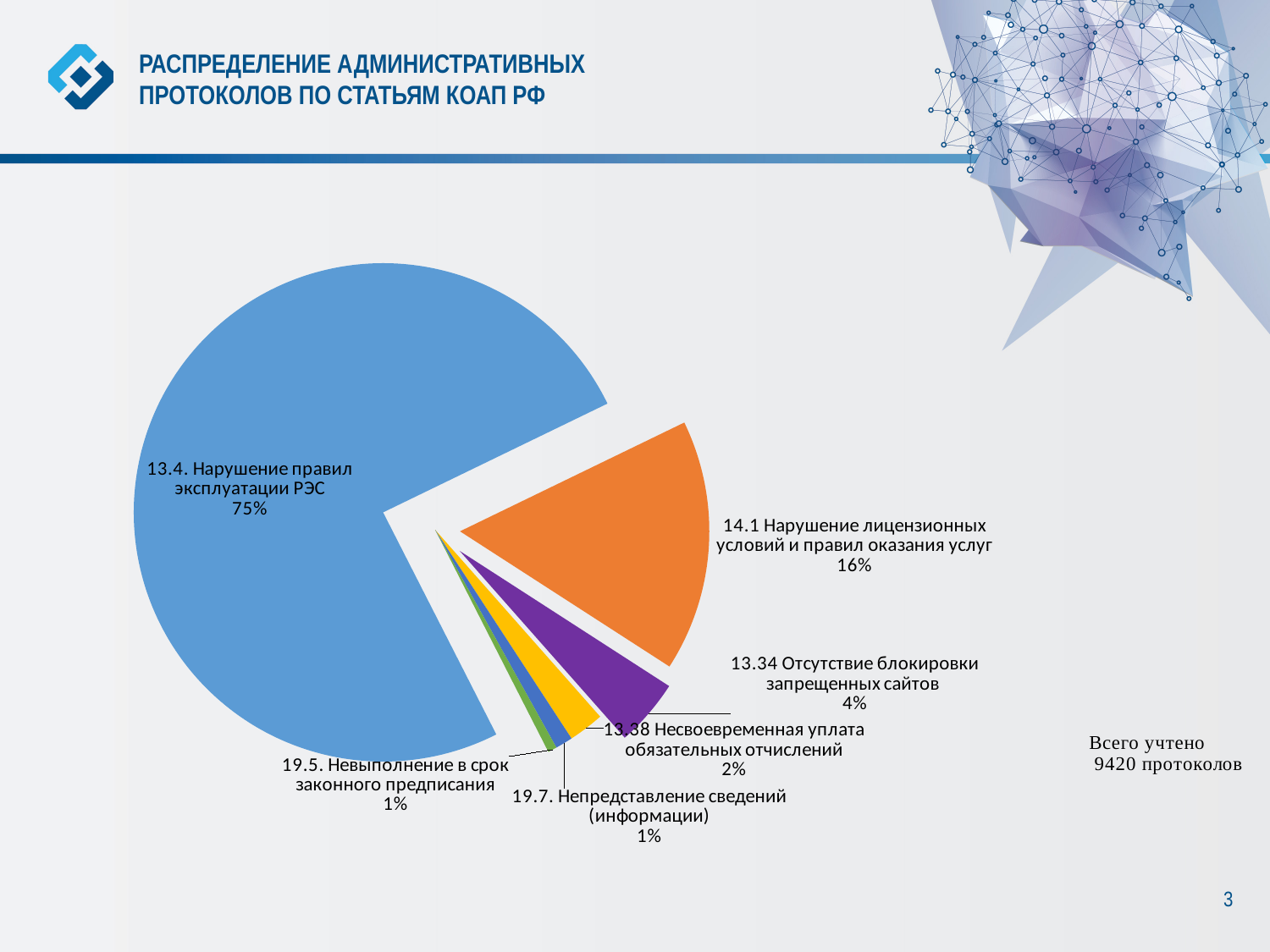
Which is larger: the slice for "13.34 Отсутствие блокировки запрещенных сайтов" or the slice for "13.38 Несвоевременная уплата обязательных отчислений"? 13.34 Отсутствие блокировки запрещенных сайтов What kind of chart is shown on the slide? pie chart What share of the pie does "14.1 Нарушение лицензионных условий и правил оказания услуг" have? 16% What is the value shown for "19.7. Непредставление сведений (информации)"? 1% What colour is the slice for "14.1 Нарушение лицензионных условий и правил оказания услуг"? orange Which category has the largest slice of the pie? 13.4. Нарушение правил эксплуатации РЭС What is the total number of protocols stated on the slide? 9420 протоколов What is the value shown for "13.38 Несвоевременная уплата обязательных отчислений"? 2% What is the difference in percentage points between "13.4. Нарушение правил эксплуатации РЭС" and "14.1 Нарушение лицензионных условий и правил оказания услуг"? 59 What is the value shown for "13.34 Отсутствие блокировки запрещенных сайтов"? 4% How many slices does the pie chart have? 6 What share of the pie does "13.4. Нарушение правил эксплуатации РЭС" have? 75%